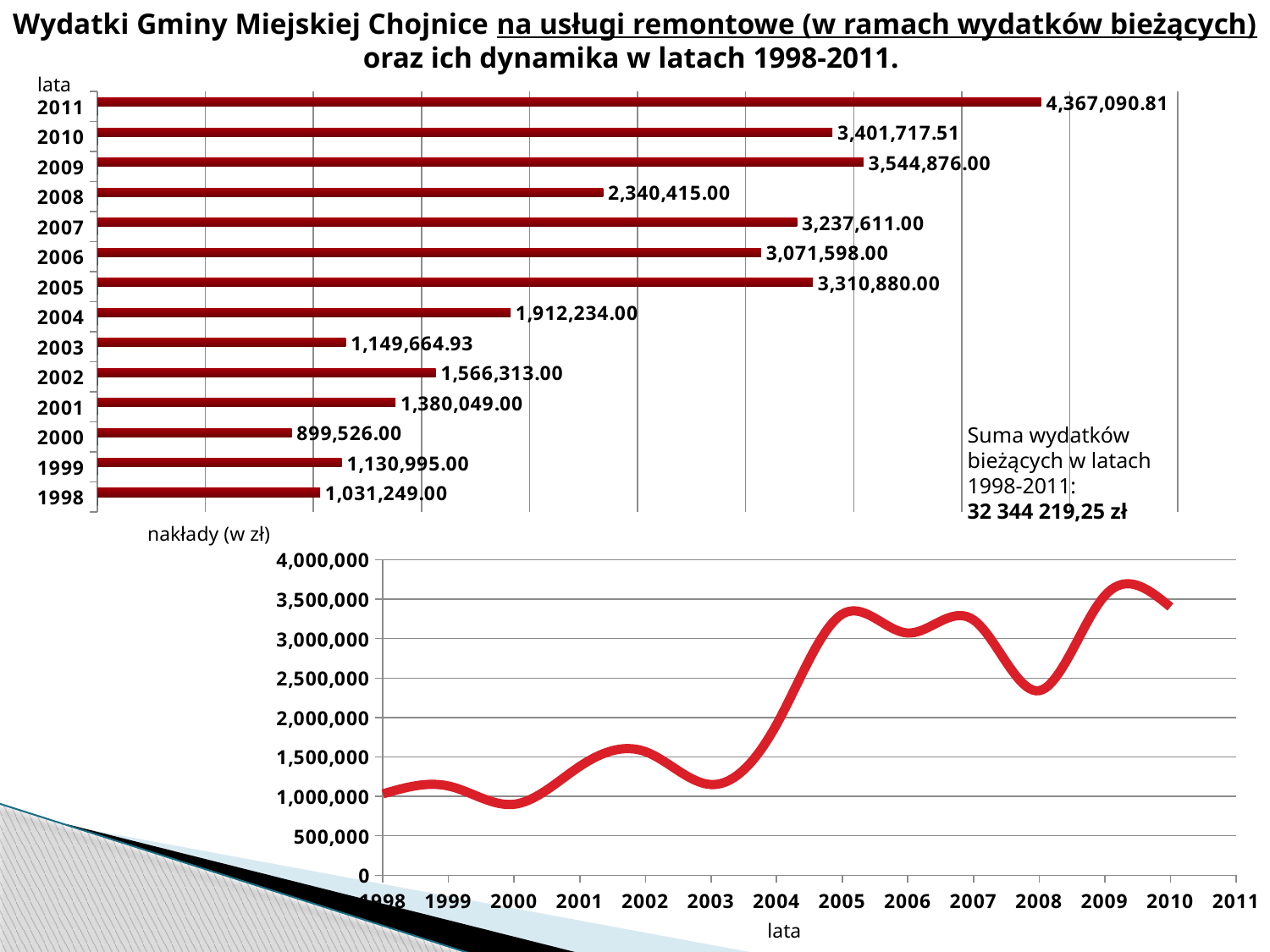
In the top bar chart, which is larger, the value for 2005 or the value for 2006? 2005 In the top bar chart, what is the difference between the values for 2011 and 2010? 965,373.30 In the top bar chart, what is the value for 2011? 4,367,090.81 In the bottom line chart, is the value for 2008 greater or less than 2,500,000? less In the top bar chart, which year has the highest value? 2011 How many bars are shown in the top bar chart? 14 In the top bar chart, what is the value for 2008? 2,340,415.00 In the bottom line chart, does the value rise or fall from 2007 to 2008? fall In the top bar chart, what is the value for 2000? 899,526.00 What kind of chart is the bottom chart on the slide? line chart In the top bar chart, what is the difference between the values for 2009 and 2008? 1,204,461.00 In the top bar chart, which year has the lowest value? 2000